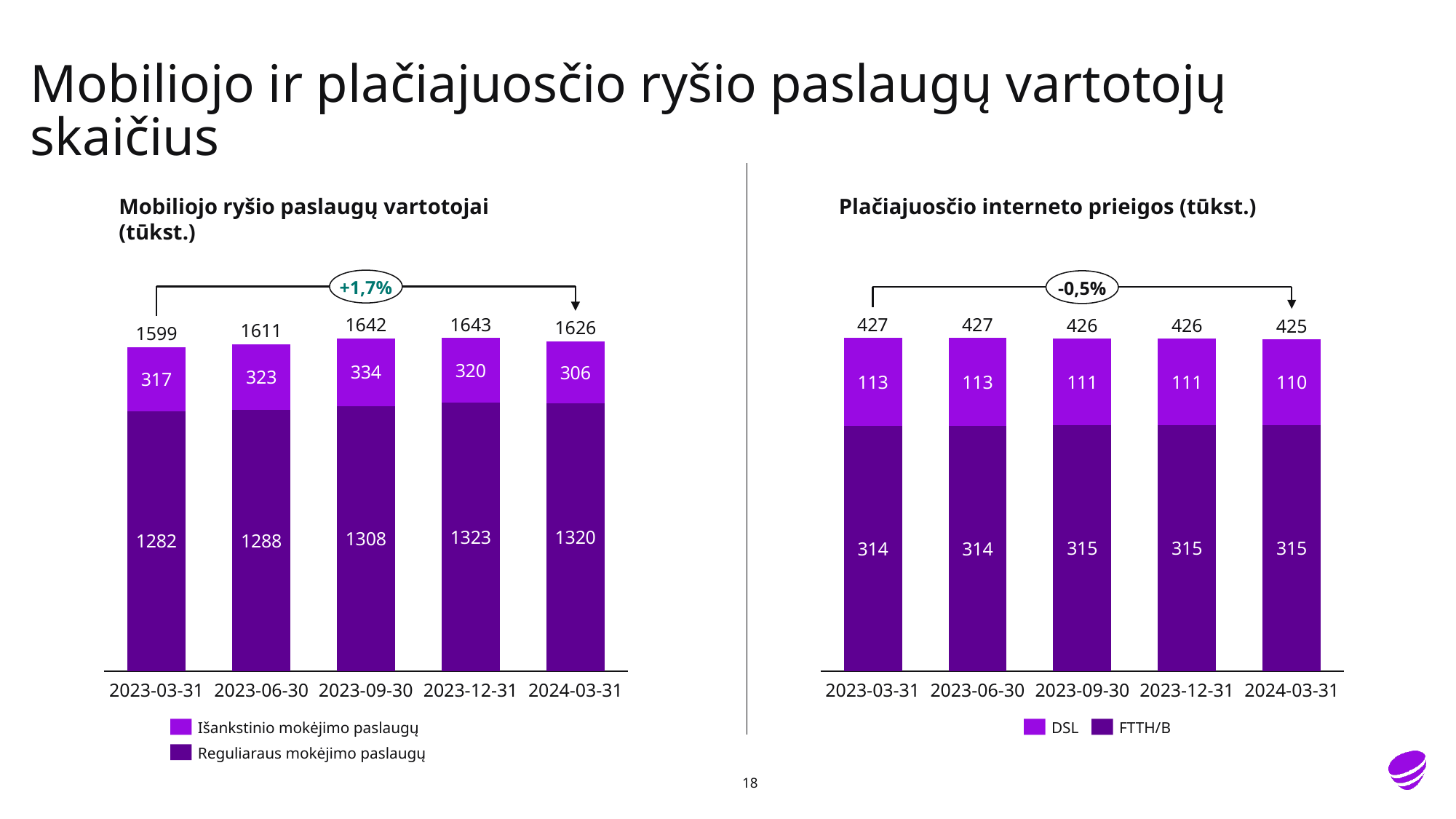
In the chart 'Plačiajuosčio interneto prieigos (tūkst.)', what is the DSL value for 2023-09-30? 111 In the chart 'Mobiliojo ryšio paslaugų vartotojai (tūkst.)', what is the total of the stacked bar for 2023-09-30? 1642 In the chart 'Mobiliojo ryšio paslaugų vartotojai (tūkst.)', what is the value for Reguliaraus mokėjimo paslaugų on 2023-12-31? 1323 In the chart 'Mobiliojo ryšio paslaugų vartotojai (tūkst.)', which date has the highest value for Išankstinio mokėjimo paslaugų? 2023-09-30 In the chart 'Mobiliojo ryšio paslaugų vartotojai (tūkst.)', what is the value for Išankstinio mokėjimo paslaugų on 2024-03-31? 306 In the chart 'Plačiajuosčio interneto prieigos (tūkst.)', how many series does the legend list? 2 In the chart 'Plačiajuosčio interneto prieigos (tūkst.)', what is the total of the stacked bar for 2024-03-31? 425 In the chart 'Mobiliojo ryšio paslaugų vartotojai (tūkst.)', what percentage change is shown in the callout above the bars? +1,7% In the chart 'Mobiliojo ryšio paslaugų vartotojai (tūkst.)', what is the difference between the Reguliaraus mokėjimo paslaugų values for 2024-03-31 and 2023-03-31? 38 What kind of chart is 'Plačiajuosčio interneto prieigos (tūkst.)'? stacked bar chart In the chart 'Plačiajuosčio interneto prieigos (tūkst.)', what is the FTTH/B value for 2024-03-31? 315 In the chart 'Plačiajuosčio interneto prieigos (tūkst.)', does the DSL value rise or fall from 2023-03-31 to 2024-03-31? fall